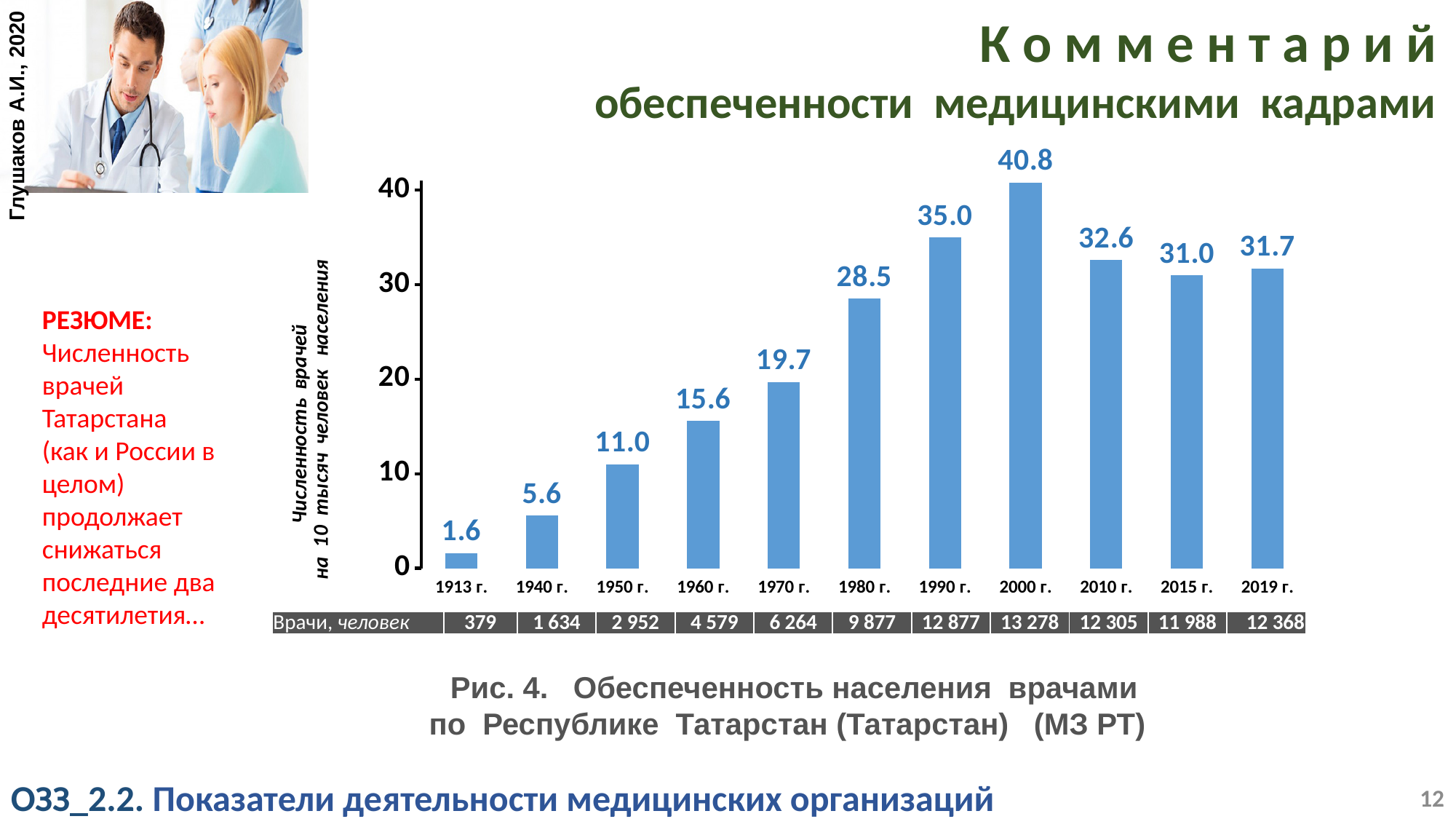
Which year has the lowest value in the chart? 1913 г. What is the difference between the values for 2000 г. and 2019 г.? 9.1 Which year has the highest value in the chart? 2000 г. What is the value for 2000 г. in the chart? 40.8 Do the values rise or fall from 1913 г. to 2000 г.? Rise What is the y-axis label of the chart? Численность врачей на 10 тысяч человек населения What kind of chart is shown on the slide? Bar chart Which is larger, the value for 2015 г. or the value for 2019 г.? 2019 г. What is the value for 2019 г. in the chart? 31.7 What is the value for 1913 г. in the chart? 1.6 How many bars (years) are shown in the chart? 11 According to the table row 'Врачи, человек', how many doctors were there in 2000 г.? 13 278